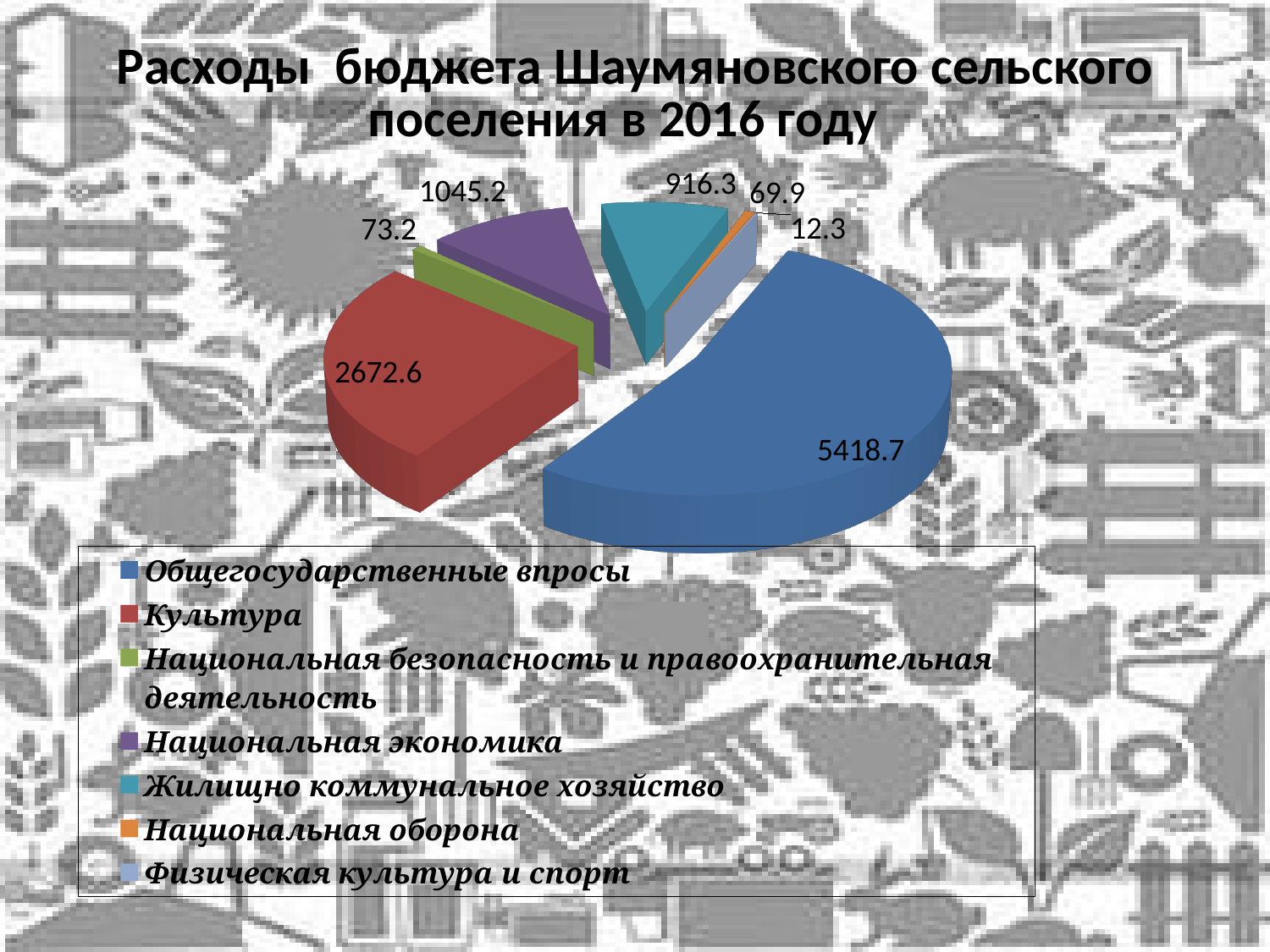
What is the value for Национальная экономика? 1045.2 What type of chart is shown on the slide? pie chart What is the value for Культура? 2672.6 What is the difference between the values for Общегосударственные впросы and Культура? 2746.1 Which category has the largest slice of the pie? Общегосударственные впросы What is the value for Жилищно коммунальное хозяйство? 916.3 How many categories does the legend list? 7 Which category has the smallest slice of the pie? Физическая культура и спорт Which is larger, the value for Национальная экономика or the value for Жилищно коммунальное хозяйство? Национальная экономика What is the title of the chart? Расходы бюджета Шаумяновского сельского поселения в 2016 году What is the value for Общегосударственные впросы? 5418.7 What is the value for Физическая культура и спорт? 12.3